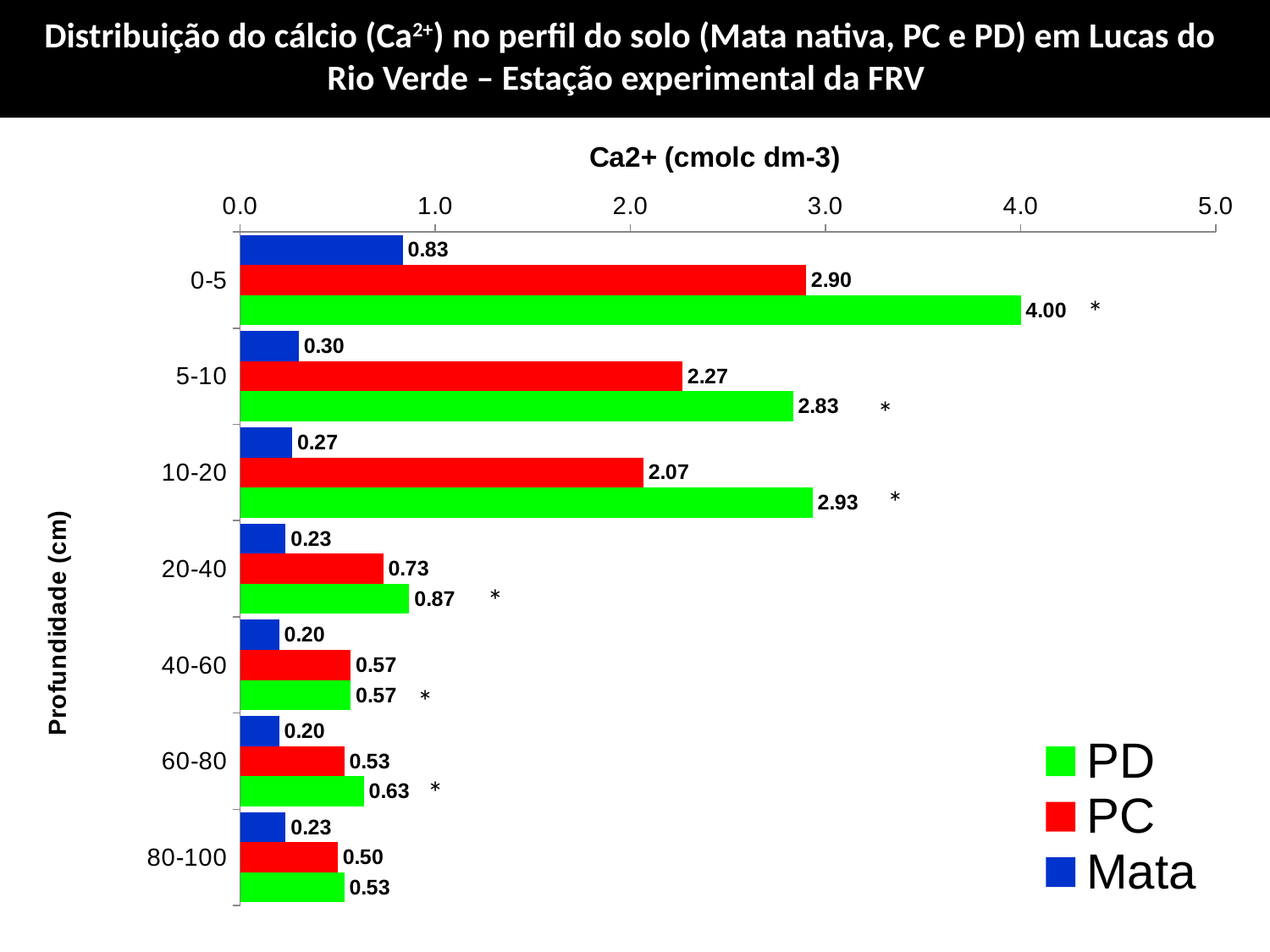
What colour represents the Mata series in the legend? blue What is the difference between the PD and PC values at the 0-5 cm depth? 1.10 How many series does the legend list? 3 Which depth has the lowest Ca2+ value for the PC series? 80-100 What is the Ca2+ value for PD at the 0-5 cm depth? 4.00 How many depth categories are shown on the chart? 7 What is the Ca2+ value for PC at the 10-20 cm depth? 2.07 Which depth has the highest Ca2+ value for the PD series? 0-5 Which is larger at the 20-40 cm depth, the PC value or the Mata value? PC Is the PD value at the 5-10 cm depth greater or less than 2.0? greater What kind of chart is shown on the slide? bar chart What is the Ca2+ value for Mata at the 5-10 cm depth? 0.30